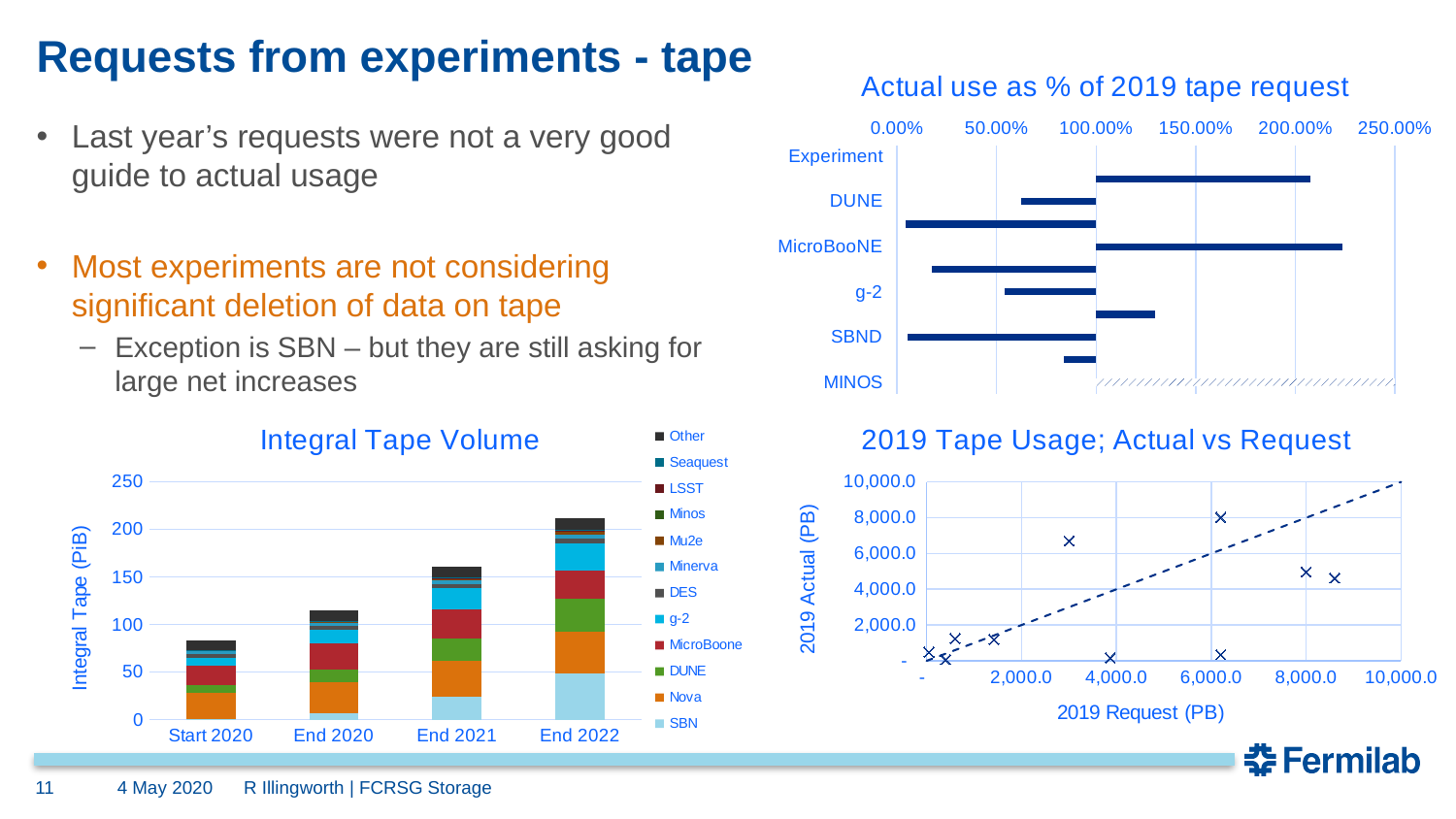
In the 'Integral Tape Volume' chart, is the total for Start 2020 greater or less than 100? less In the 'Integral Tape Volume' chart, which category has the highest total stacked bar? End 2022 In the 'Integral Tape Volume' chart, is the total for End 2022 greater or less than 200? greater In the '2019 Tape Usage; Actual vs Request' chart, what is the x-axis label? 2019 Request (PB) In the 'Integral Tape Volume' chart, how many series does the legend list? 12 In the 'Actual use as % of 2019 tape request' chart, is the value for MicroBooNE greater or less than 200.00%? greater In the 'Integral Tape Volume' chart, which category has the lowest total stacked bar? Start 2020 What type of chart is the 'Integral Tape Volume' chart? stacked bar chart In the 'Integral Tape Volume' chart, what is the y-axis label? Integral Tape (PiB) In the 'Integral Tape Volume' chart, do the total bar heights rise or fall from Start 2020 to End 2022? rise What type of chart is the '2019 Tape Usage; Actual vs Request' chart? scatter chart In the 'Integral Tape Volume' chart, how many categories are shown on the x axis? 4